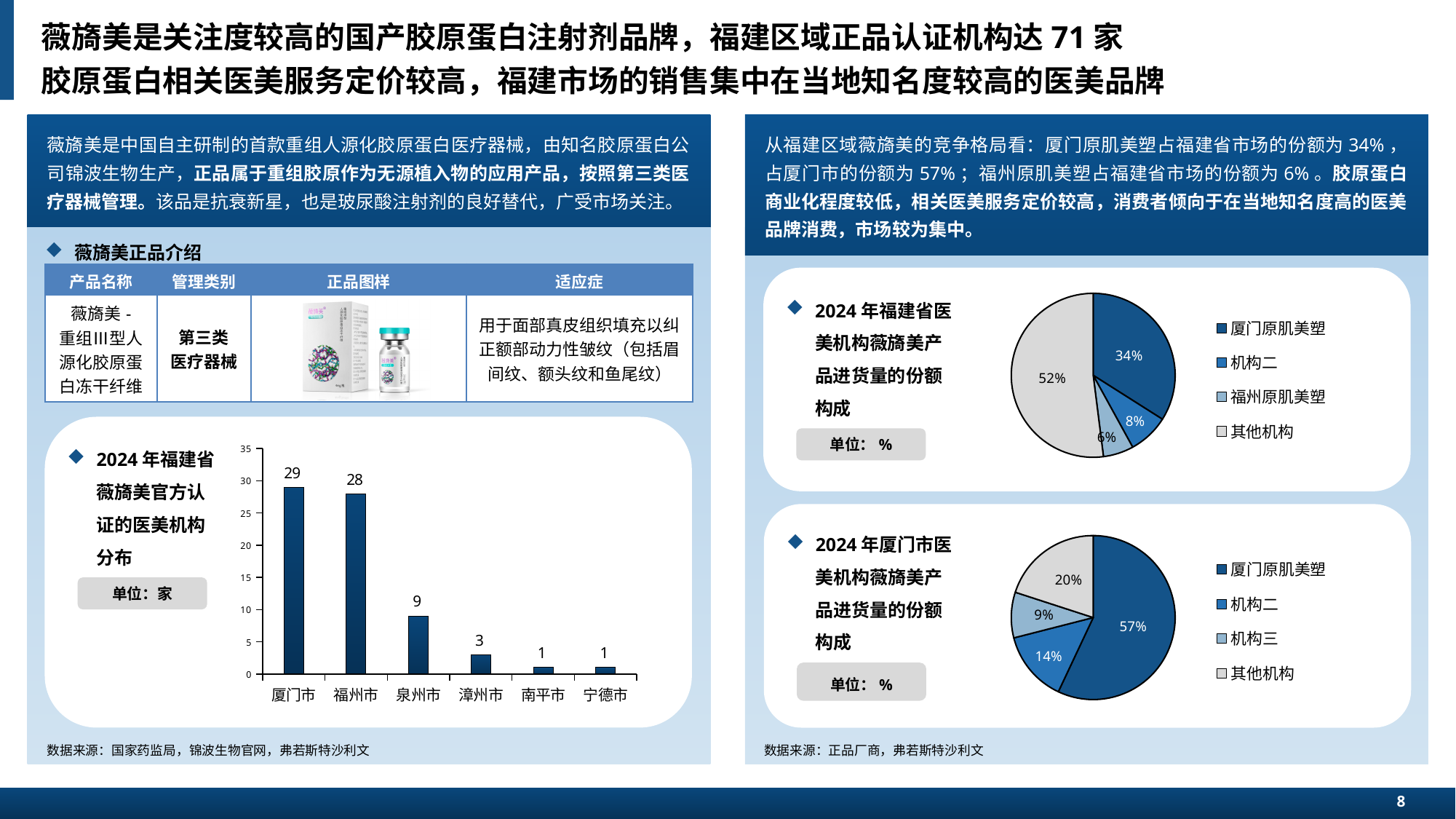
In the pie chart titled 2024年福建省医美机构薇旖美产品进货量的份额构成, what is the share for 福州原肌美塑? 6% In the pie chart titled 2024年厦门市医美机构薇旖美产品进货量的份额构成, what is the difference between the shares of 机构二 and 机构三? 5% In the bar chart titled 2024年福建省薇旖美官方认证的医美机构分布, what is the difference between 厦门市 and 福州市? 1 In the bar chart titled 2024年福建省薇旖美官方认证的医美机构分布, how many cities are shown on the x axis? 6 In the pie chart titled 2024年福建省医美机构薇旖美产品进货量的份额构成, what is the share for 厦门原肌美塑? 34% What type of chart is the chart titled 2024年福建省薇旖美官方认证的医美机构分布? bar chart In the bar chart titled 2024年福建省薇旖美官方认证的医美机构分布, what is the value for 厦门市? 29 In the bar chart titled 2024年福建省薇旖美官方认证的医美机构分布, do the values rise or fall from left to right along the x axis? fall In the pie chart titled 2024年厦门市医美机构薇旖美产品进货量的份额构成, which category has the largest share? 厦门原肌美塑 In the bar chart titled 2024年福建省薇旖美官方认证的医美机构分布, what is the value for 泉州市? 9 How many entries does the legend of the pie chart titled 2024年厦门市医美机构薇旖美产品进货量的份额构成 list? 4